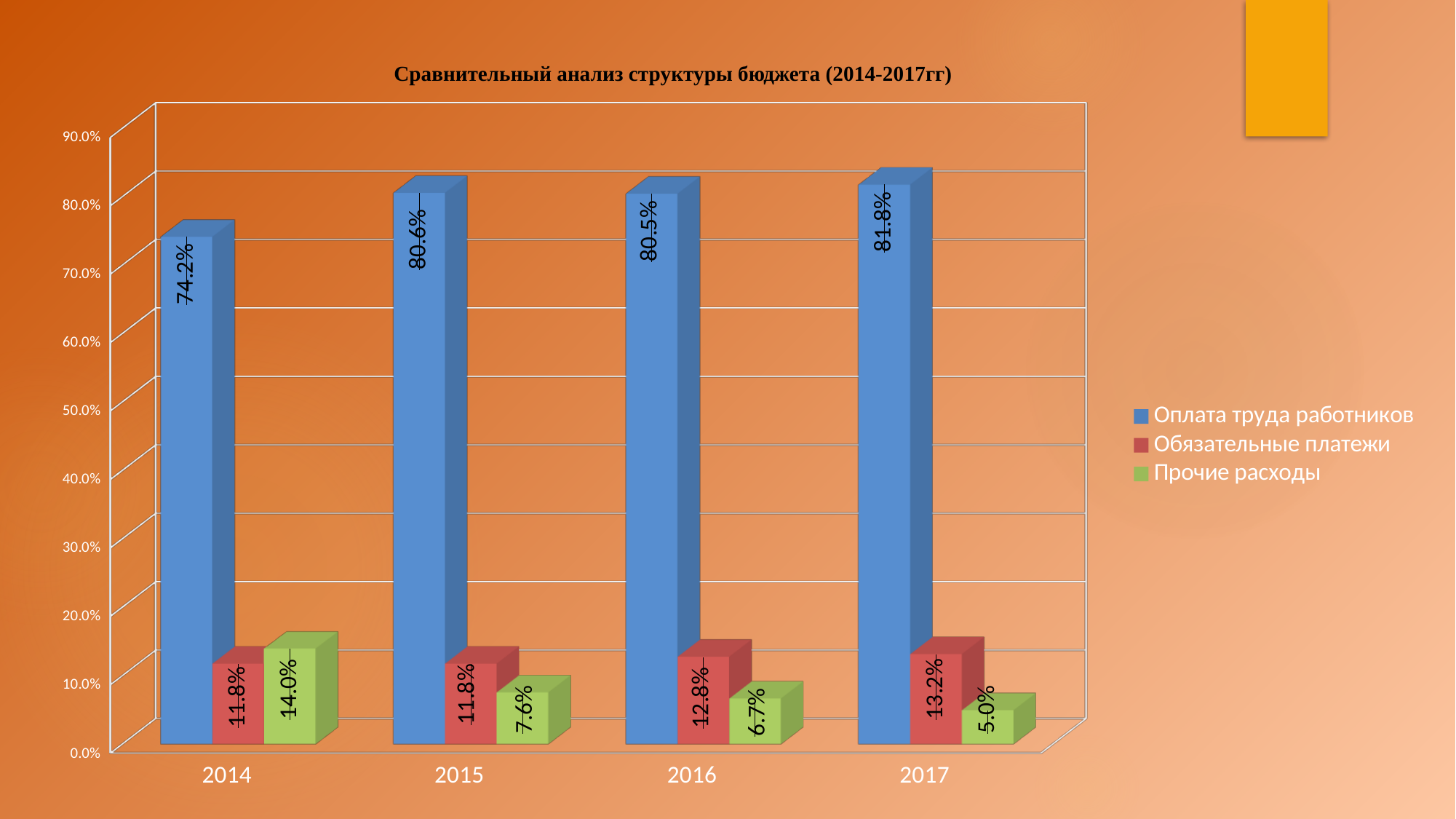
What is the value for Прочие расходы in 2017? 5.0% Does the value for Прочие расходы rise or fall from 2014 to 2017? fall What is the value for Обязательные платежи in 2016? 12.8% What kind of chart is shown on the slide? bar chart What is the difference between Оплата труда работников in 2017 and in 2014? 7.6% What is the value for Оплата труда работников in 2014? 74.2% How many years are shown on the x axis? 4 In which year is Прочие расходы lowest? 2017 What is the title of the chart? Сравнительный анализ структуры бюджета (2014-2017гг) In which year is Оплата труда работников highest? 2017 Which is larger in 2014: Обязательные платежи or Прочие расходы? Прочие расходы How many series does the legend list? 3